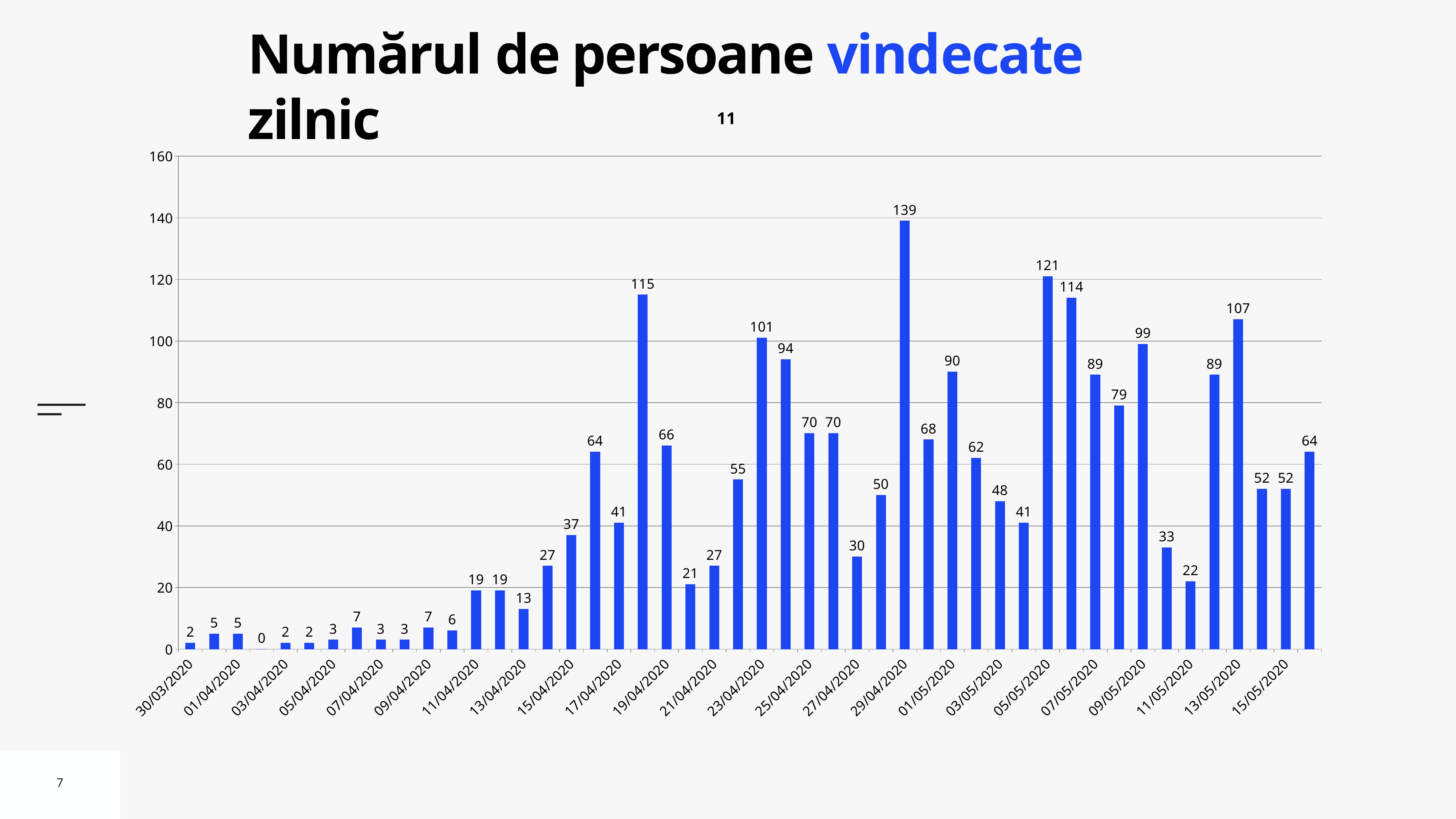
What is the value for 29/04/2020? 139 What kind of chart is shown on the slide? bar chart Is the value for 19/04/2020 greater or less than 60? greater What is the value for 15/05/2020? 52 What is the value for 05/05/2020? 121 Which date has the highest value? 29/04/2020 What is the difference between the values for 29/04/2020 and 05/05/2020? 18 Which is larger, the value for 23/04/2020 or the value for 09/05/2020? 23/04/2020 What is the lowest value shown on the chart? 0 What is the value for 30/03/2020? 2 What is the highest value shown on the vertical axis? 160 What is the value for 13/05/2020? 107